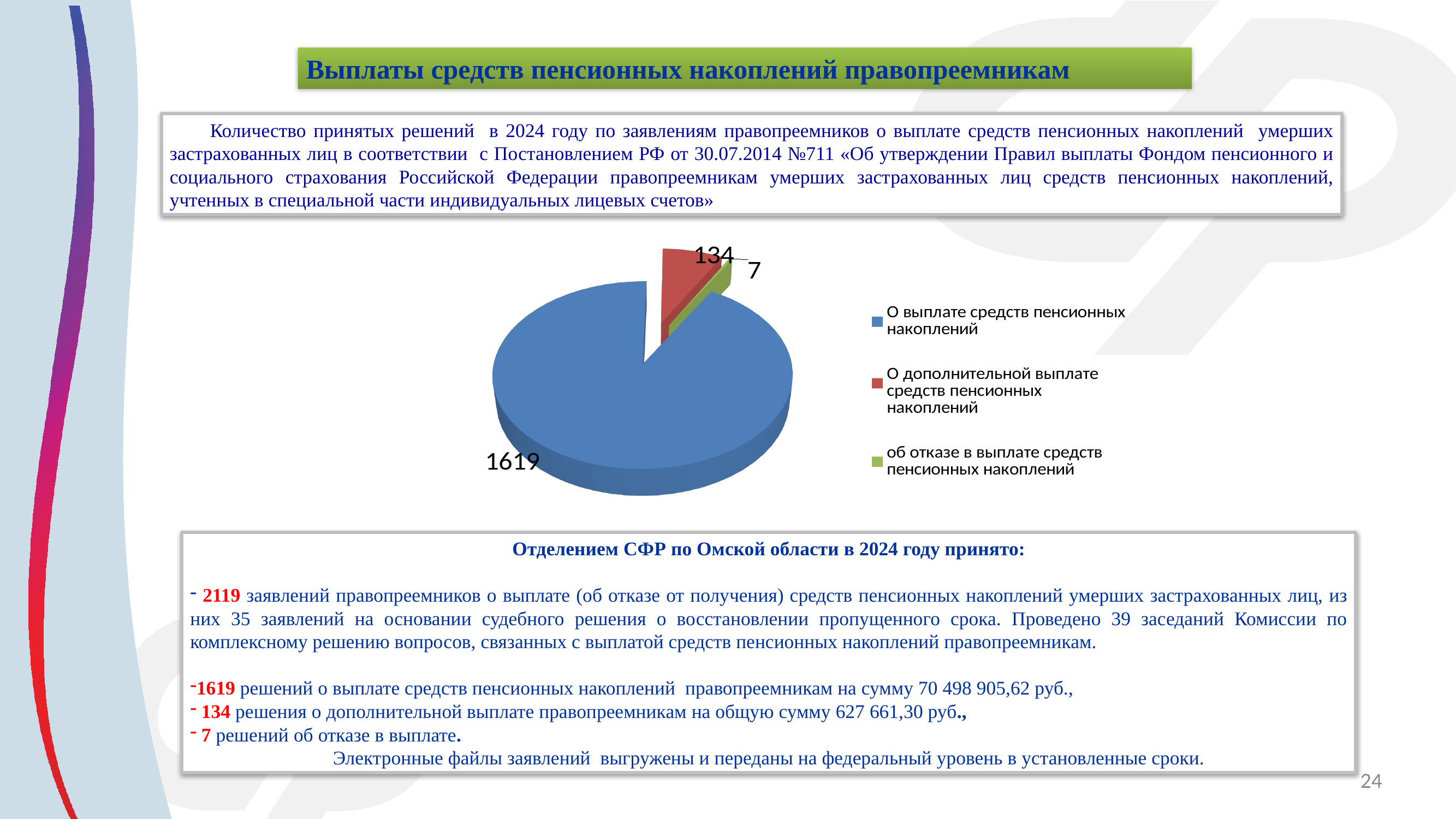
What is the difference between the values for "О дополнительной выплате средств пенсионных накоплений" and "об отказе в выплате средств пенсионных накоплений"? 127 Which category has the largest slice in the pie chart? О выплате средств пенсионных накоплений Which category has the smallest slice in the pie chart? об отказе в выплате средств пенсионных накоплений What is the difference between the values for "О выплате средств пенсионных накоплений" and "О дополнительной выплате средств пенсионных накоплений"? 1485 How many slices does the pie chart have? 3 What is the value of the slice "О дополнительной выплате средств пенсионных накоплений"? 134 What kind of chart is shown on the slide? pie chart How many entries does the legend of the pie chart list? 3 Which is larger: the slice for "О дополнительной выплате средств пенсионных накоплений" or the slice for "об отказе в выплате средств пенсионных накоплений"? О дополнительной выплате средств пенсионных накоплений What is the value of the slice "об отказе в выплате средств пенсионных накоплений"? 7 What is the value of the slice "О выплате средств пенсионных накоплений"? 1619 What colour is the slice for "О выплате средств пенсионных накоплений"? blue